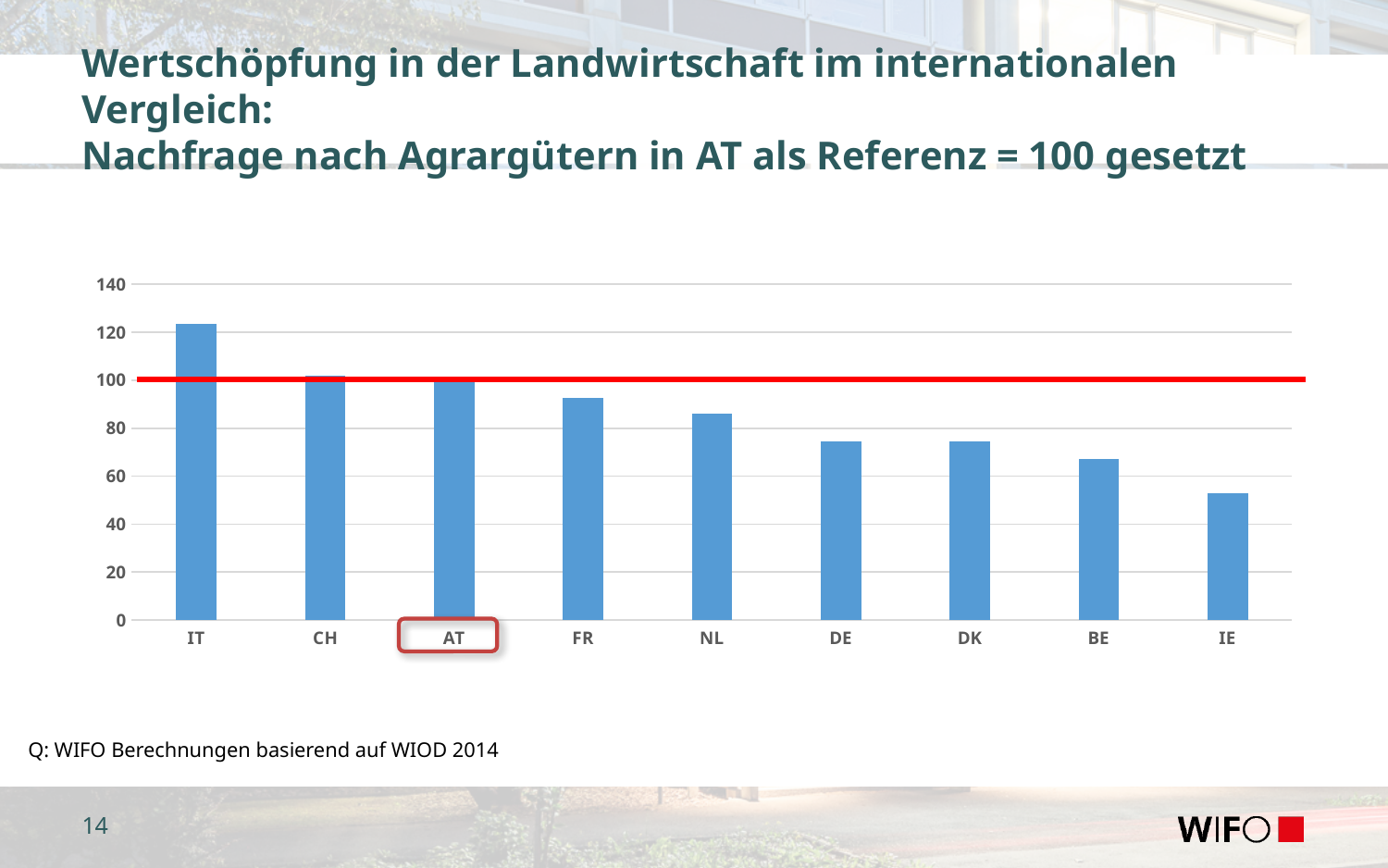
Which has the larger value, IT or FR? IT Which country has the highest bar in the chart? IT Do the bar values rise or fall from left to right along the x axis? fall Which country has the lowest bar in the chart? IE What is the value for AT, the reference country, in the chart? 100 Is the value for IE greater or less than 60? less What kind of chart is shown on the slide? bar chart At which value on the y axis is the red horizontal line drawn? 100 Is the value for IT greater or less than 100? greater Is the value for NL greater or less than 80? greater How many countries are shown on the x axis of the chart? 9